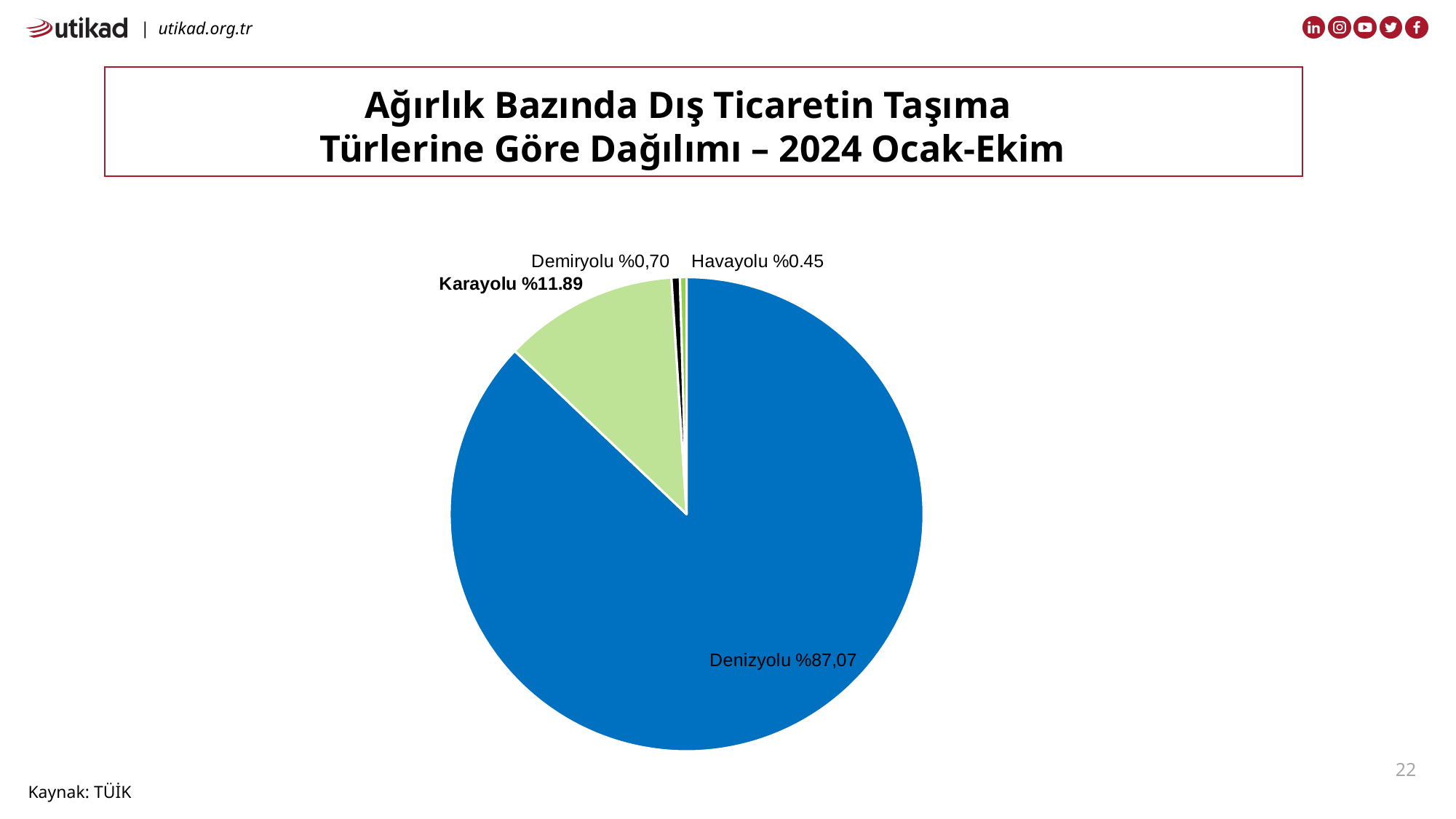
Which transport mode has the smallest slice of the pie? Havayolu What is the share shown for Denizyolu? %87,07 What source is cited for the chart data? TÜİK What is the share shown for Karayolu? %11.89 Which transport mode has the largest slice of the pie? Denizyolu How many slices does the pie chart have? 4 Which is larger, the share for Karayolu or the share for Demiryolu? Karayolu What is the share shown for Demiryolu? %0,70 What is the title of the chart on the slide? Ağırlık Bazında Dış Ticaretin Taşıma Türlerine Göre Dağılımı – 2024 Ocak-Ekim What is the difference in percentage points between the Denizyolu share (87,07) and the Karayolu share (11.89)? 75.18 What kind of chart is shown on the slide? Pie chart What is the share shown for Havayolu? %0.45